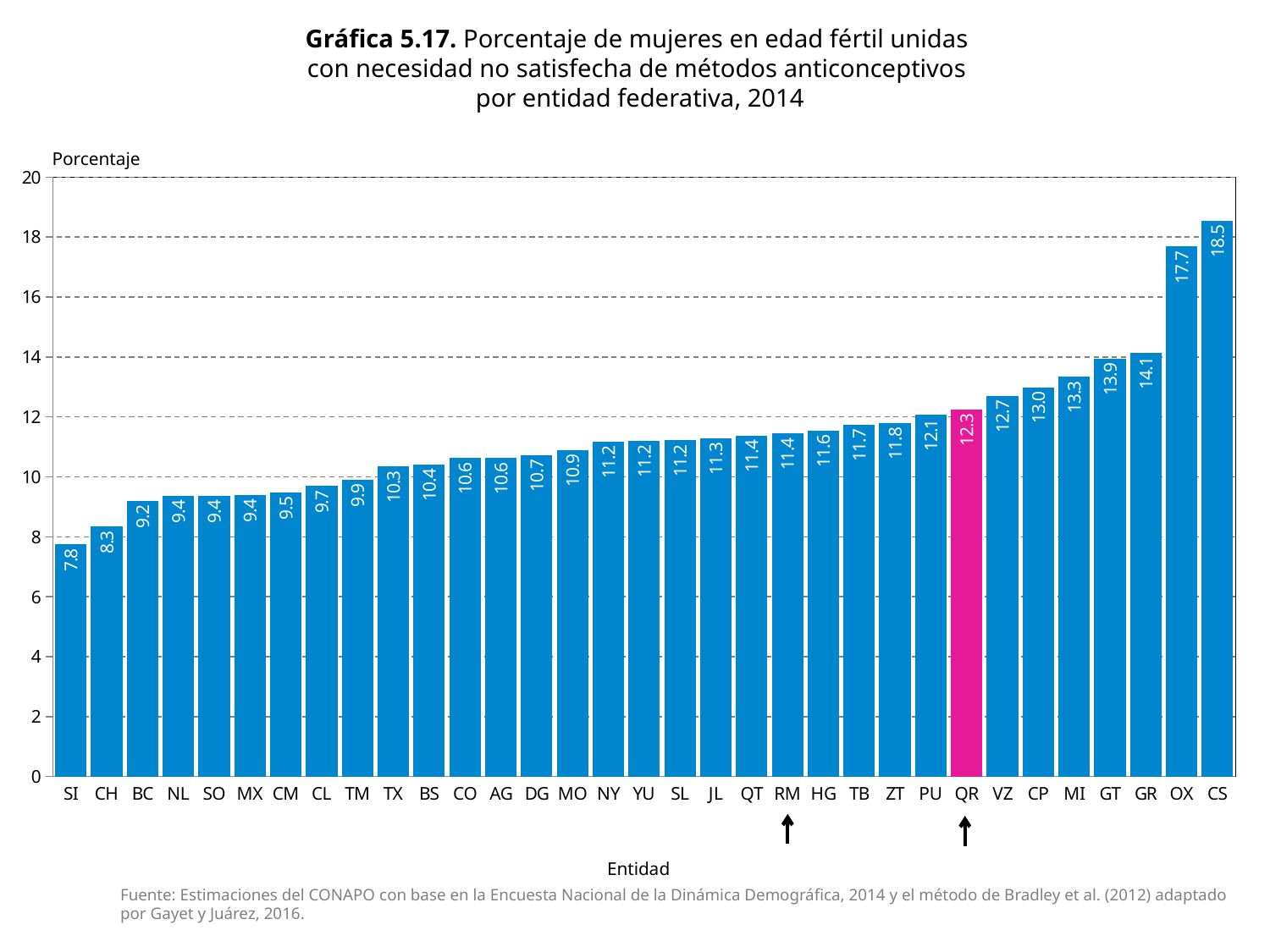
Which bar is highlighted in pink instead of blue? QR What is the value for RM? 11.4 Is the value for CS greater or less than 18? greater What kind of chart is this? Bar chart Which entity has the lowest percentage? SI What is the difference between the values for CS and OX? 0.8 Which entity has the highest percentage? CS Which is larger, the value for OX or the value for GR? OX What is the value for QR? 12.3 What is the value for CS? 18.5 How many entities are shown on the x axis? 33 What is the difference between the values for QR and RM? 0.9